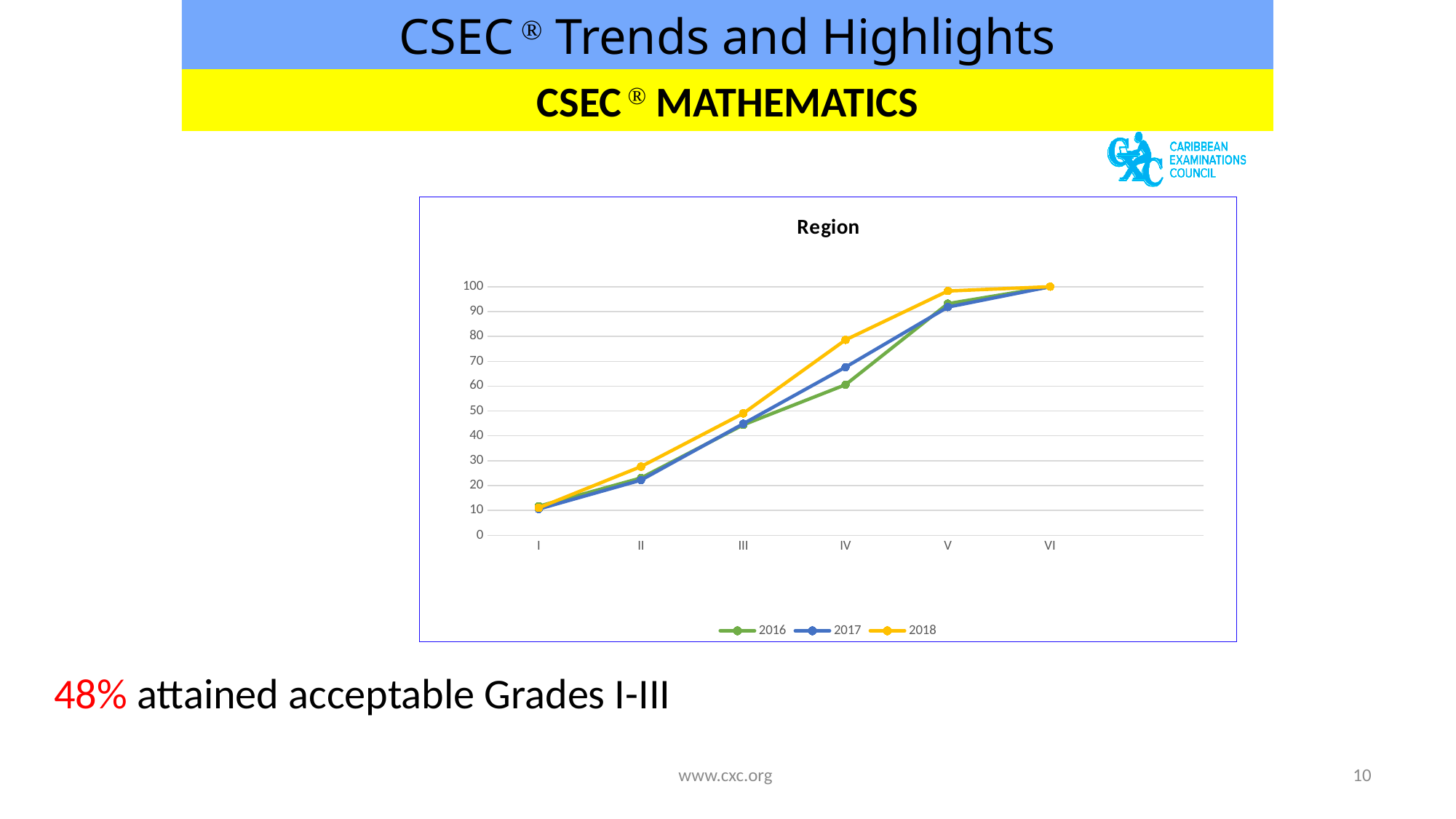
At category IV, which series has the larger value, 2016 or 2018? 2018 Do the values for the 2018 series rise or fall from category I to category VI? rise How many series does the legend of the chart list? 3 Which category has the lowest value for the 2017 series? I What is the value for the 2018 series at category VI? 100 At category II, which series has the larger value, 2017 or 2018? 2018 What kind of chart is shown on the slide? line chart Which category has the highest value for the 2018 series? VI Is the value for the 2018 series at category IV greater or less than 70? greater What is the title of the chart? Region How many categories are shown on the x axis of the chart? 6 Is the value for the 2016 series at category III greater or less than 50? less